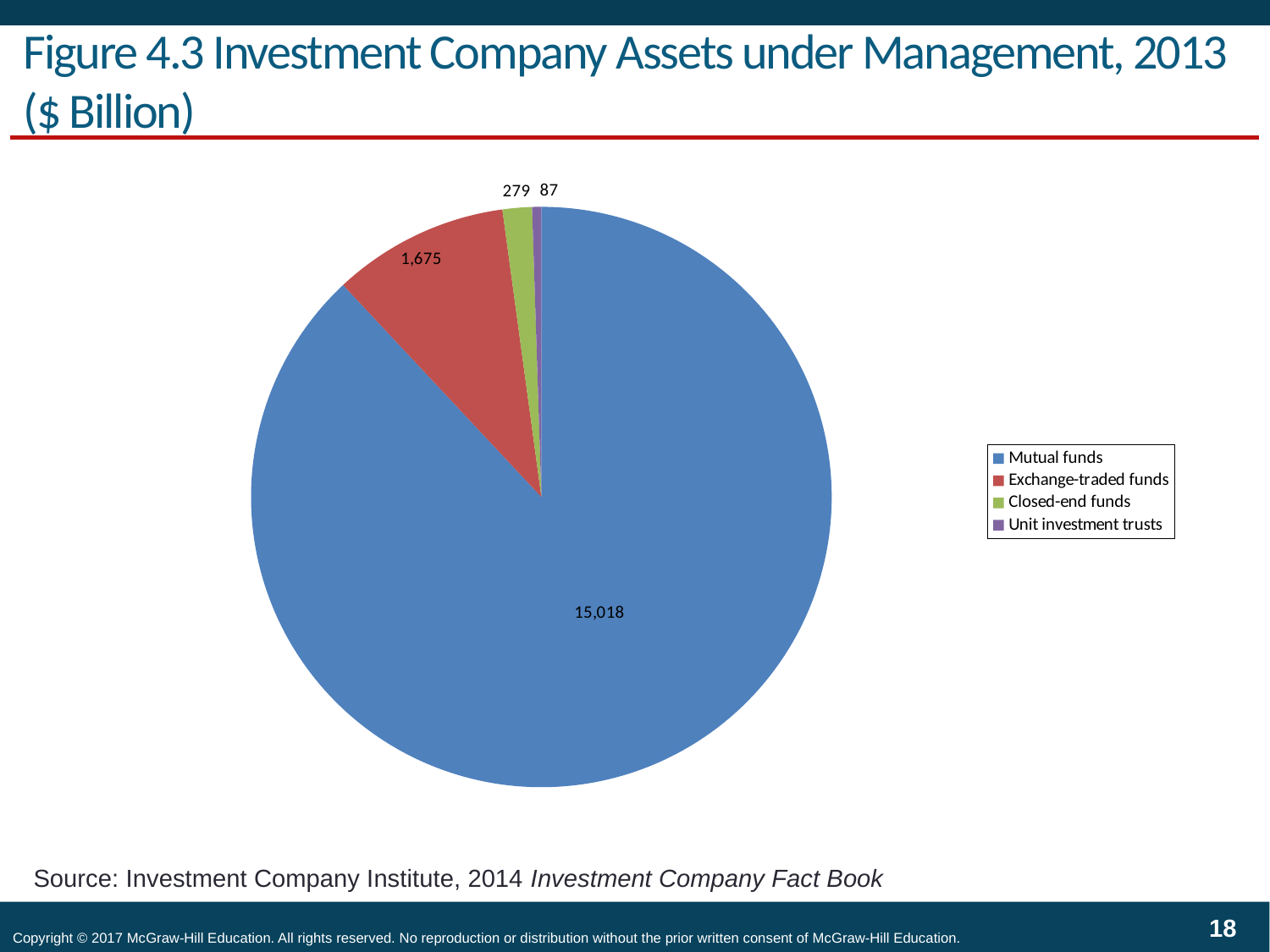
What type of chart is shown on the slide? Pie chart Which category has the largest share of assets under management? Mutual funds What is the difference between the values for Closed-end funds and Unit investment trusts? 192 What colour is the slice for Exchange-traded funds? Red Which category has the smallest share of assets under management? Unit investment trusts What is the value for Exchange-traded funds? 1,675 What is the value for Closed-end funds? 279 What is the value for Unit investment trusts? 87 Which is larger, the value for Exchange-traded funds or the value for Closed-end funds? Exchange-traded funds What is the value for Mutual funds? 15,018 What is the difference between the values for Mutual funds and Exchange-traded funds? 13,343 How many categories does the legend list? 4